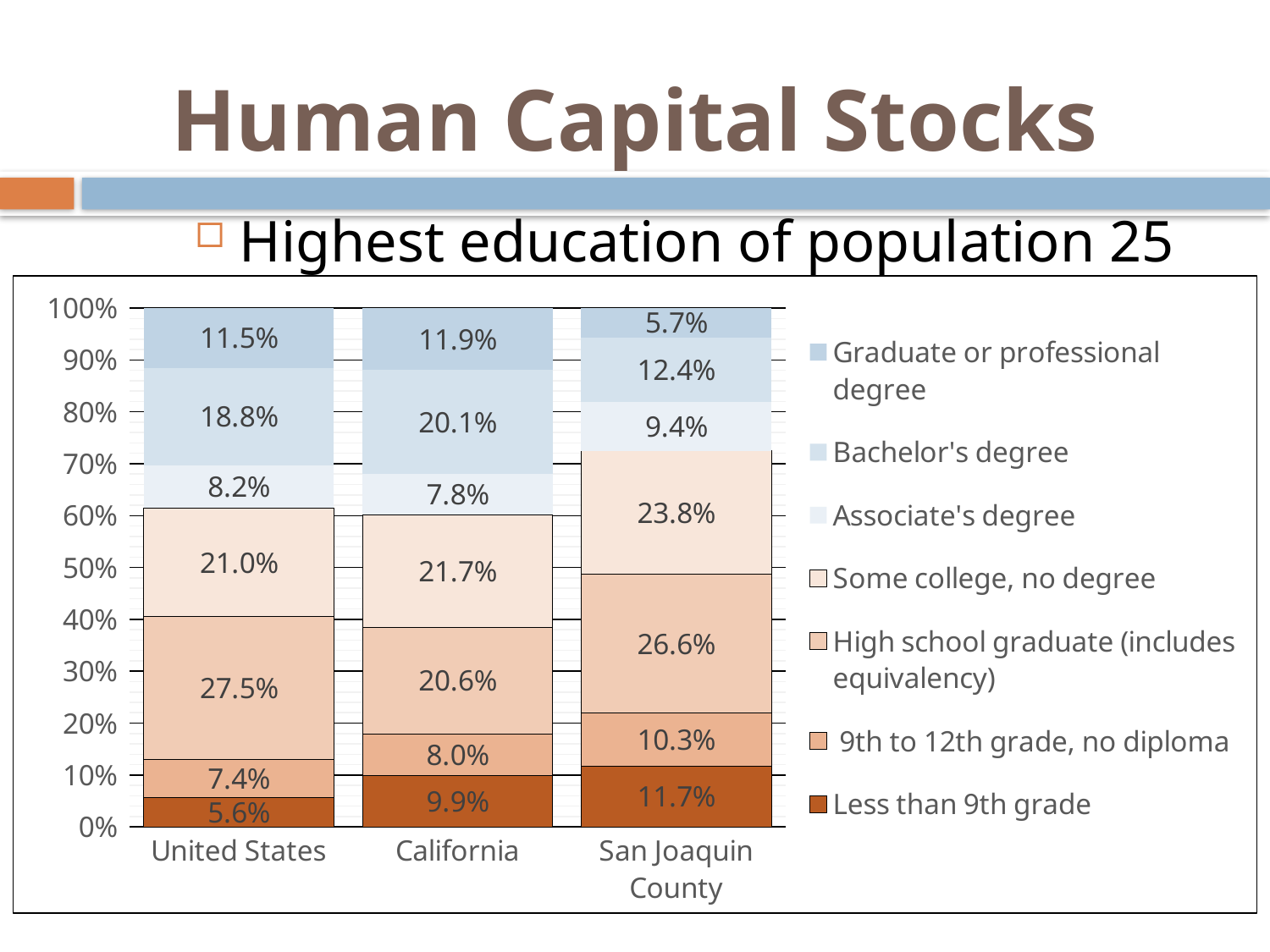
Which series is shown in the darkest orange colour at the bottom of each bar? Less than 9th grade Which is larger, the 9th to 12th grade, no diploma value for California or for San Joaquin County? San Joaquin County How many series does the legend list? 7 How many categories are shown on the x axis? 3 What kind of chart is shown on the slide? Stacked bar chart What is the value for High school graduate (includes equivalency) in the United States? 27.5% What is the value for Bachelor's degree in California? 20.1% What is the value for Associate's degree in San Joaquin County? 9.4% Which category has the highest value for Graduate or professional degree? California What is the difference between the Some college, no degree values for San Joaquin County and the United States? 2.8% What is the value for Less than 9th grade in San Joaquin County? 11.7% Which category has the lowest value for Bachelor's degree? San Joaquin County